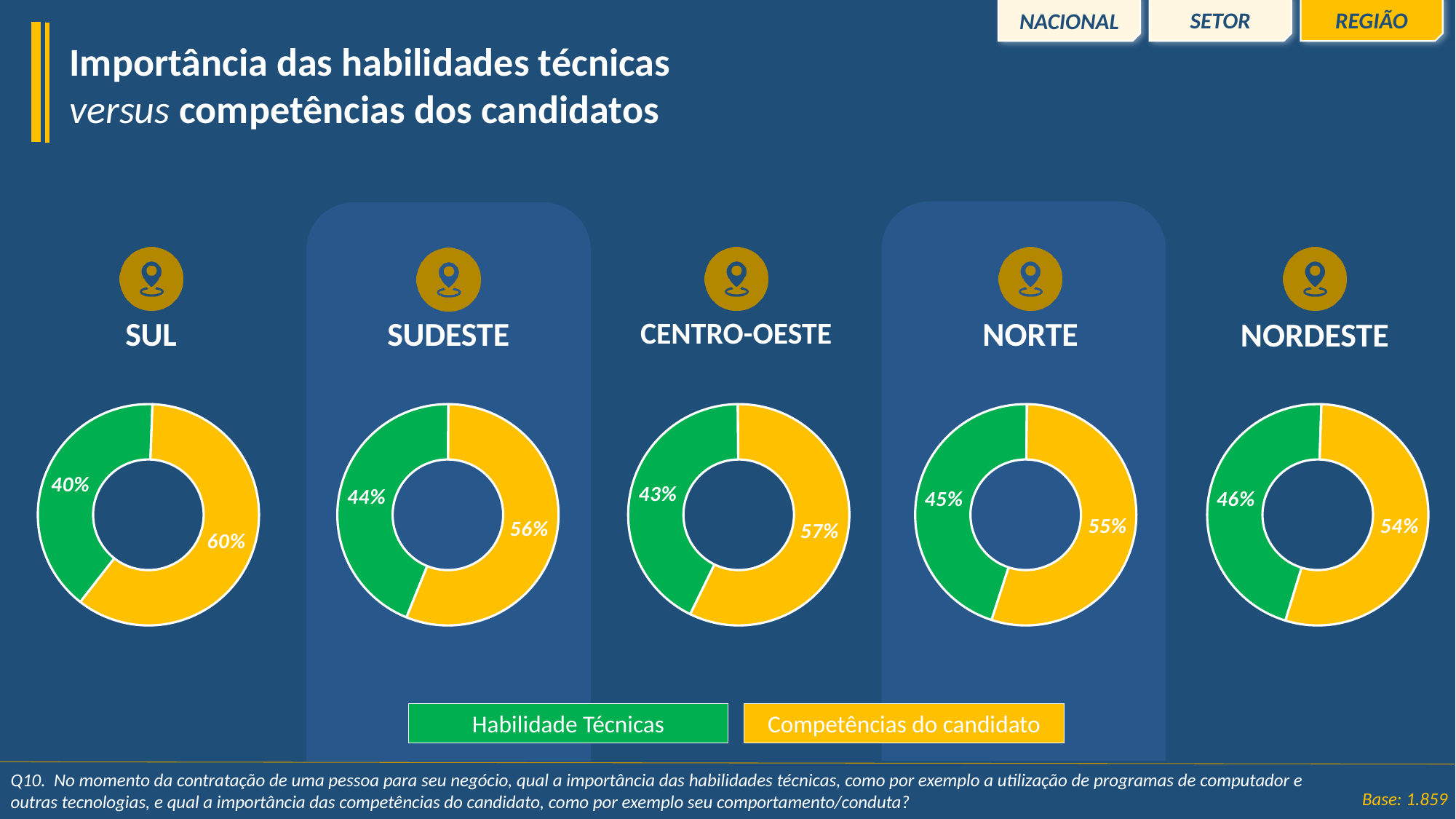
What kind of chart is used for each region on the slide? Donut chart In the NORTE chart, what percentage is shown for Competências do candidato? 55% In the SUL chart, what is the difference between Competências do candidato and Habilidade Técnicas? 20 percentage points In the NORDESTE chart, what percentage is shown for Habilidade Técnicas? 46% Across the five regional charts, which region has the lowest value for Habilidade Técnicas? SUL In the SUL chart, what percentage is shown for Habilidade Técnicas? 40% How many entries does the legend at the bottom of the slide list? 2 How many regional charts are shown on the slide? 5 Across the five regional charts, which region has the highest value for Competências do candidato? SUL In the NORDESTE chart, which is larger: Habilidade Técnicas or Competências do candidato? Competências do candidato In the CENTRO-OESTE chart, what percentage is shown for Habilidade Técnicas? 43% In the SUDESTE chart, what percentage is shown for Competências do candidato? 56%